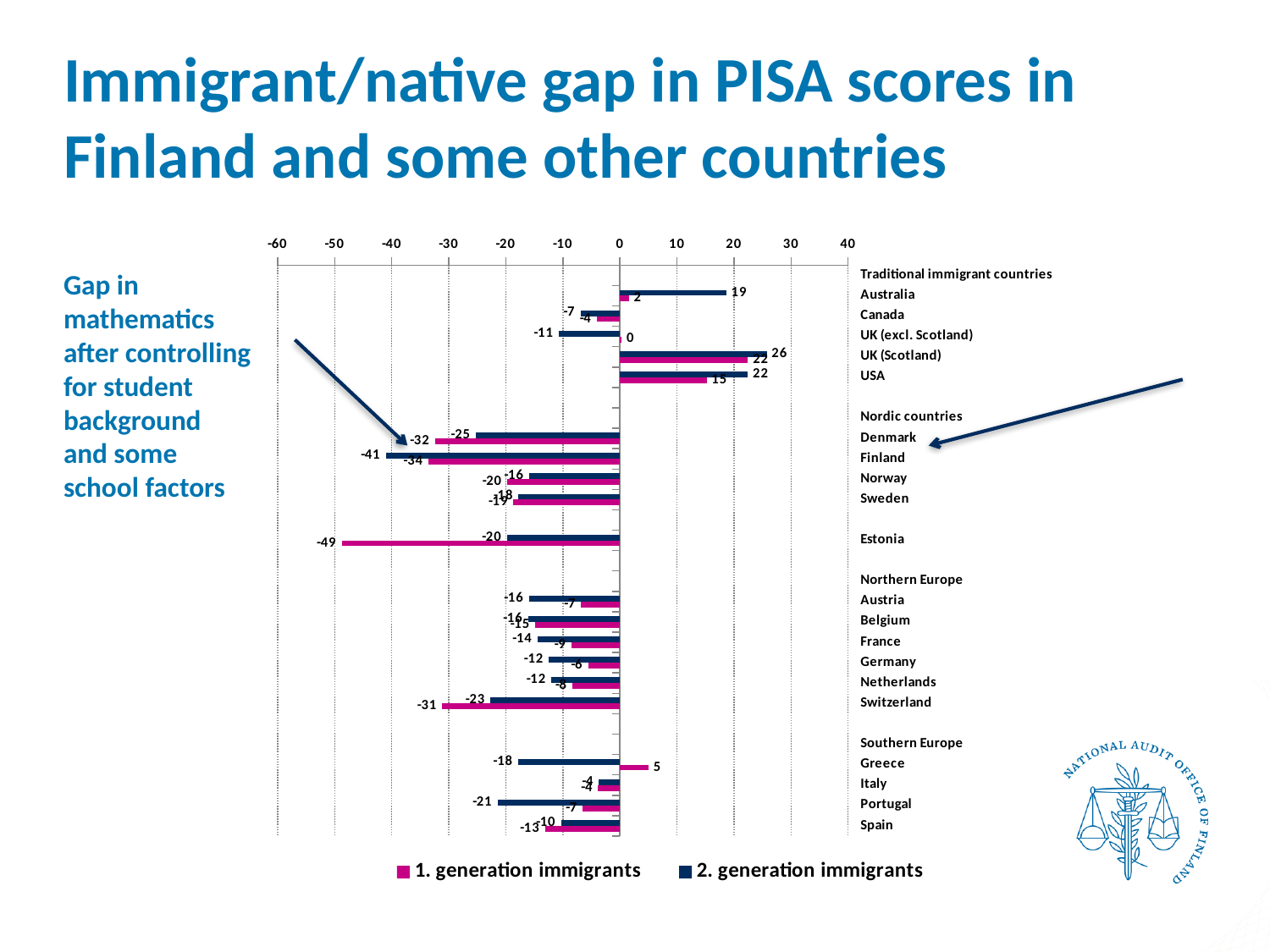
Which country has the lowest value for 1. generation immigrants? Estonia Which country has the highest value for 2. generation immigrants? UK (Scotland) What is the difference between the 1. generation (-34) and 2. generation (-41) values for Finland? 7 Which is larger, the 1. generation immigrants value for Denmark or for Finland? Denmark What is the value for 1. generation immigrants in the USA? 15 What is the value for 1. generation immigrants in Estonia? -49 How many series does the legend list? 2 What kind of chart is shown on the slide? bar chart What are the two entries in the chart legend? 1. generation immigrants and 2. generation immigrants What is the value for 2. generation immigrants in Finland? -41 What is the value for 1. generation immigrants in Greece? 5 What is the value for 2. generation immigrants in UK (Scotland)? 26